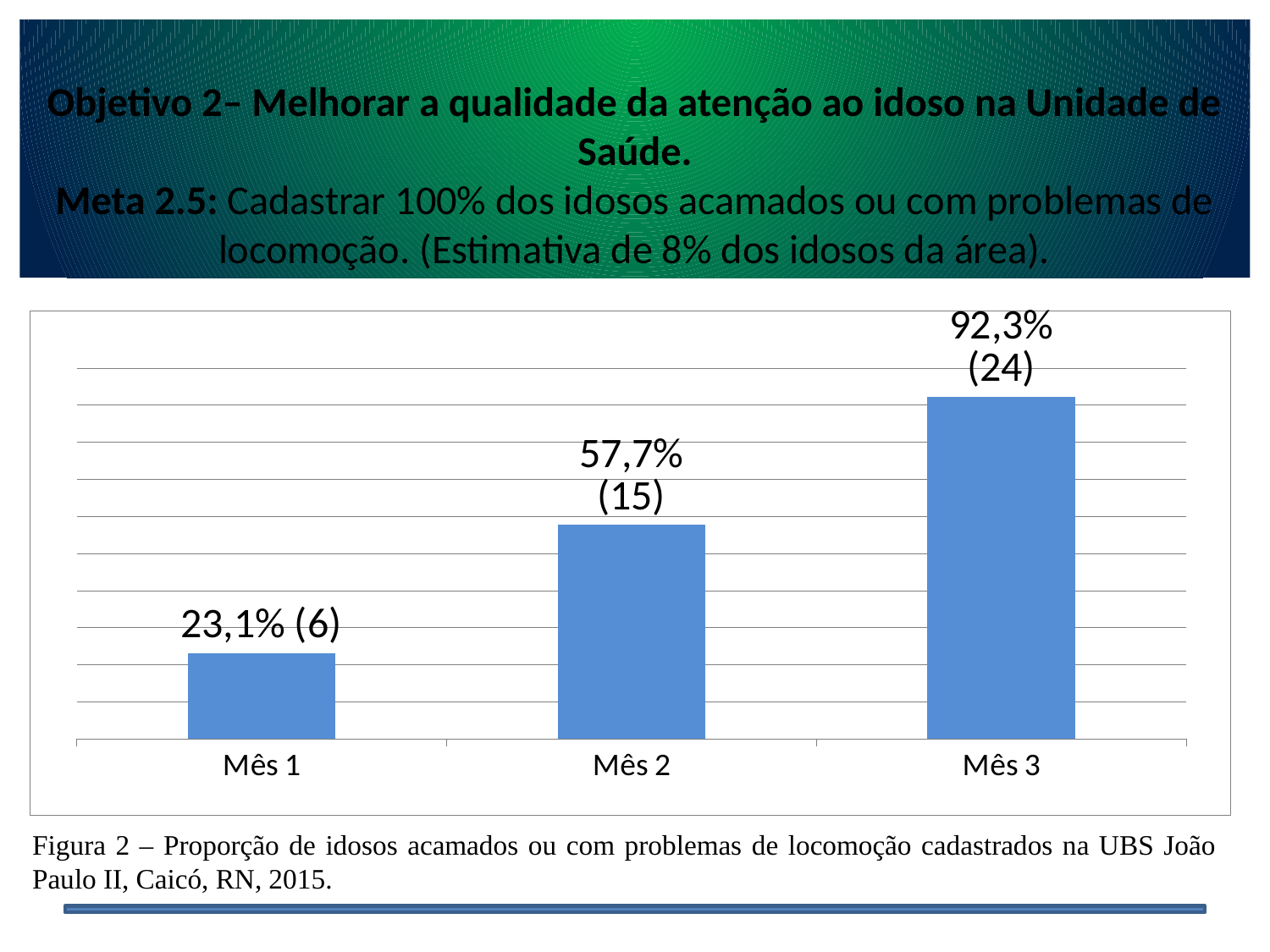
How many months (categories) are shown on the chart? 3 Which month has the highest value? Mês 3 What percentage is shown for Mês 3? 92,3% Do the values rise or fall from Mês 1 to Mês 3? Rise What percentage is shown for Mês 2? 57,7% What is the difference in percentage points between Mês 3 and Mês 1? 69,2 What kind of chart is shown on the slide? Bar chart Which is larger, the value for Mês 2 or the value for Mês 3? Mês 3 Which month has the lowest value? Mês 1 What is the difference in percentage points between Mês 2 and Mês 1? 34,6 How many elderly people (the number in parentheses) are shown for Mês 3? 24 What is the value shown for Mês 1? 23,1% (6)